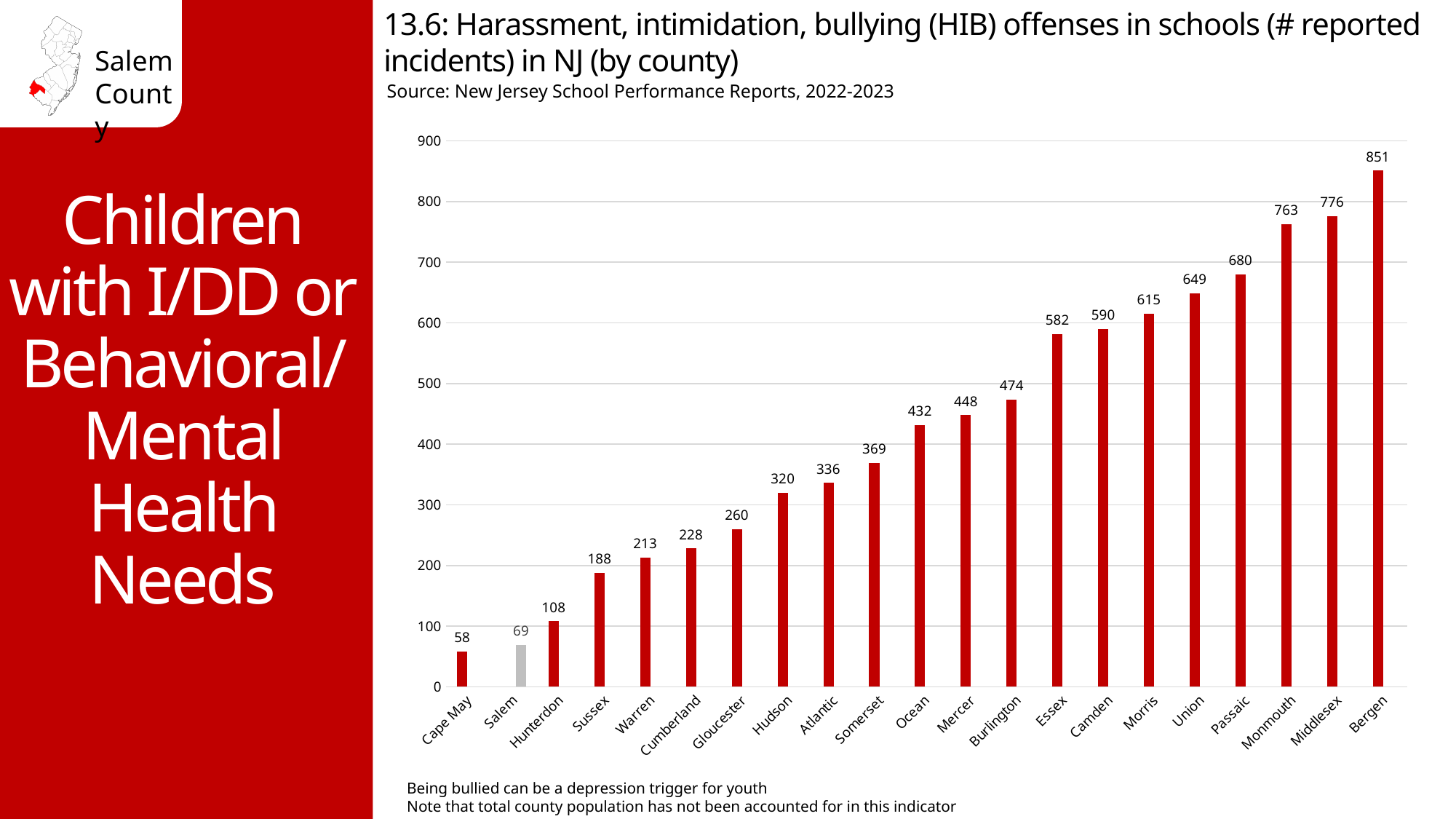
Which county has the highest number of reported HIB incidents? Bergen How many counties are shown on the chart? 21 What is the number of reported HIB incidents for Gloucester County? 260 Which county has more reported HIB incidents, Camden or Essex? Camden What is the source cited for the chart data? New Jersey School Performance Reports, 2022-2023 What is the difference in reported HIB incidents between Bergen and Salem? 782 What kind of chart is shown on the slide? Bar chart Is the value for Monmouth greater or less than 700? greater Which county has the lowest number of reported HIB incidents? Cape May What is the number of reported HIB incidents for Salem County? 69 Which county's bar is shown in grey rather than red? Salem Do the values rise or fall moving from left to right along the x axis? Rise